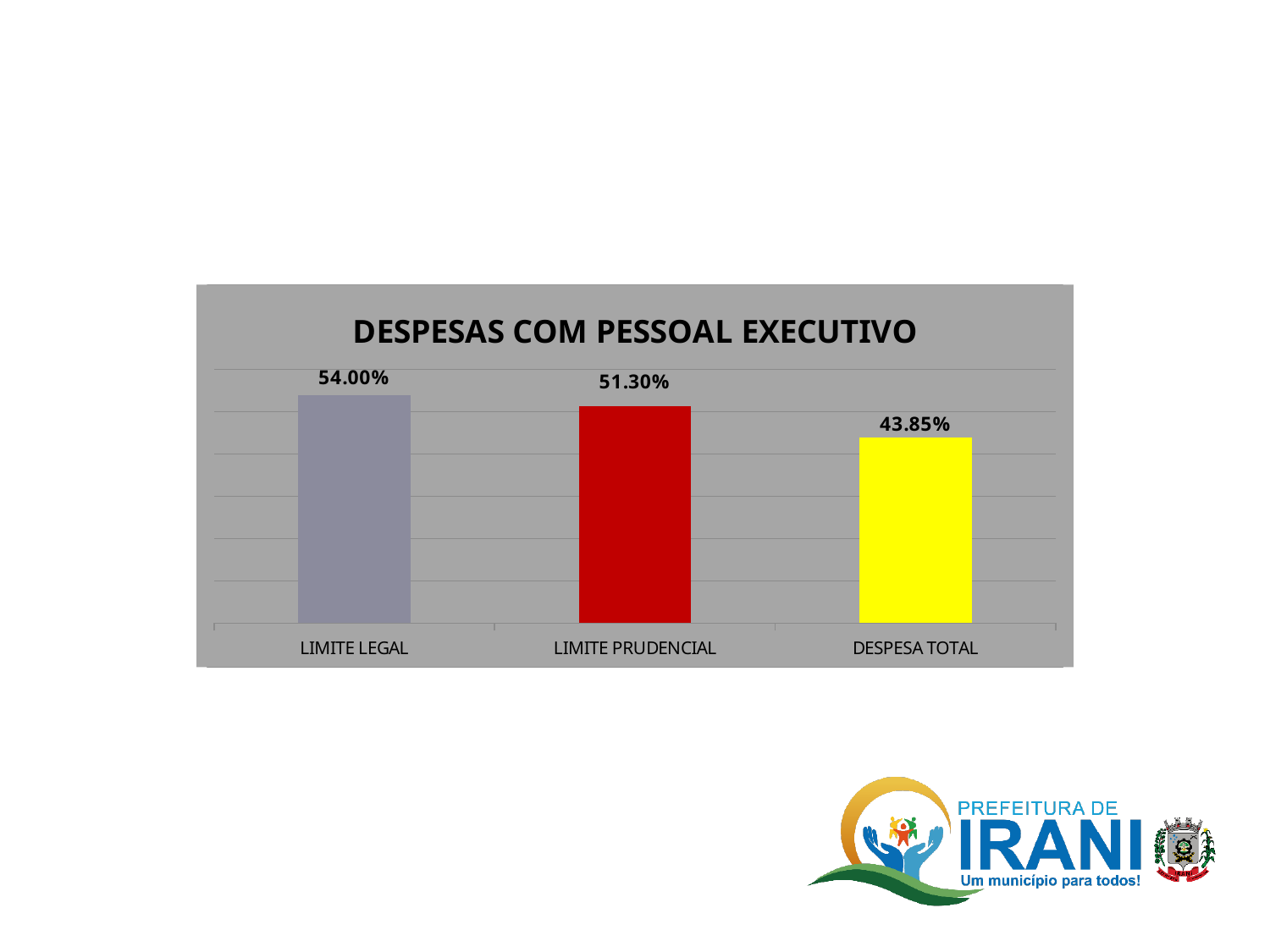
What is the value for LIMITE LEGAL? 54.00% What is the difference between LIMITE LEGAL and LIMITE PRUDENCIAL? 2.70% Which category has the highest value? LIMITE LEGAL What is the value for LIMITE PRUDENCIAL? 51.30% What kind of chart is shown on the slide? bar chart What is the difference between LIMITE LEGAL and DESPESA TOTAL? 10.15% Which is larger, LIMITE PRUDENCIAL or DESPESA TOTAL? LIMITE PRUDENCIAL What is the title of the chart? DESPESAS COM PESSOAL EXECUTIVO Do the values rise or fall from left to right across the categories? fall What is the value for DESPESA TOTAL? 43.85% How many categories are shown in the chart? 3 Which category has the lowest value? DESPESA TOTAL